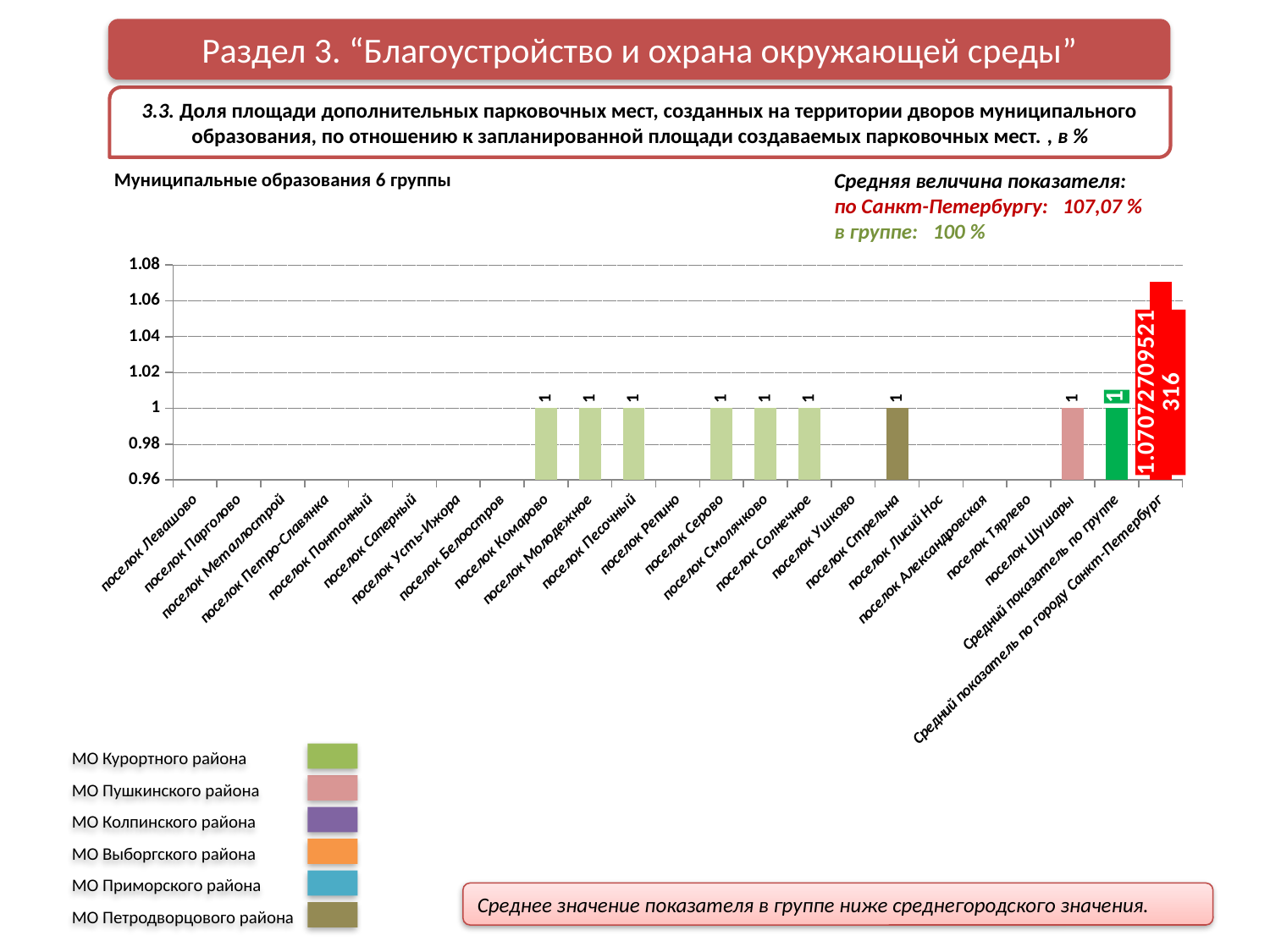
Which is larger: the value for поселок Стрельна or the value for Средний показатель по городу Санкт-Петербург? Средний показатель по городу Санкт-Петербург Which legend group does the brown bar for поселок Стрельна belong to? МО Петродворцового района Which category has the highest value? Средний показатель по городу Санкт-Петербург What is the value for поселок Шушары? 1 According to the text on the slide, what is the average value of the indicator for Санкт-Петербург? 107,07 % What is the value for поселок Солнечное? 1 What is the value for Средний показатель по группе? 1 How many entries does the legend at the bottom of the slide list? 6 Is the value for Средний показатель по городу Санкт-Петербург greater or less than 1.06? greater How many categories are shown on the x axis of the chart? 23 What is the value for поселок Комарово? 1 What kind of chart is shown on the slide? bar chart